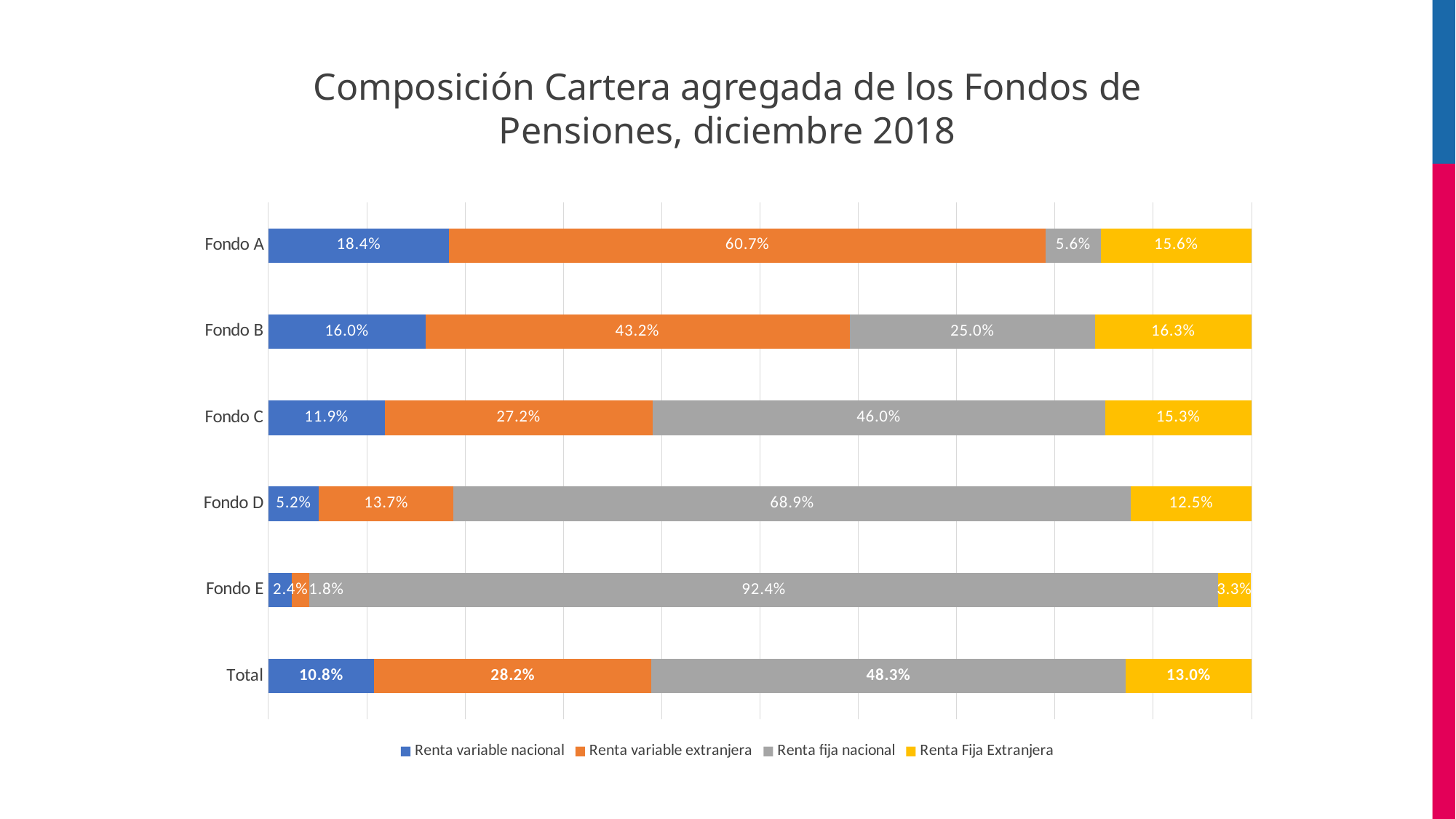
Which fund has the highest Renta fija nacional share? Fondo E Does the Renta variable nacional share rise or fall going from Fondo A down to Fondo E? Fall What is the Renta Fija Extranjera value for Fondo B? 16.3% How many series does the legend list? 4 Which fund has the lowest Renta variable extranjera share? Fondo E What is the Renta variable extranjera value for Fondo A? 60.7% How many bars (categories) are shown on the chart? 6 What is the difference between the Renta variable extranjera values for Fondo A and Fondo B? 17.5% What is the Renta variable nacional value for the Total bar? 10.8% What is the Renta fija nacional value for Fondo D? 68.9% What kind of chart is shown on the slide? Stacked bar chart Which is larger, the Renta fija nacional value for Fondo B or for Fondo C? Fondo C